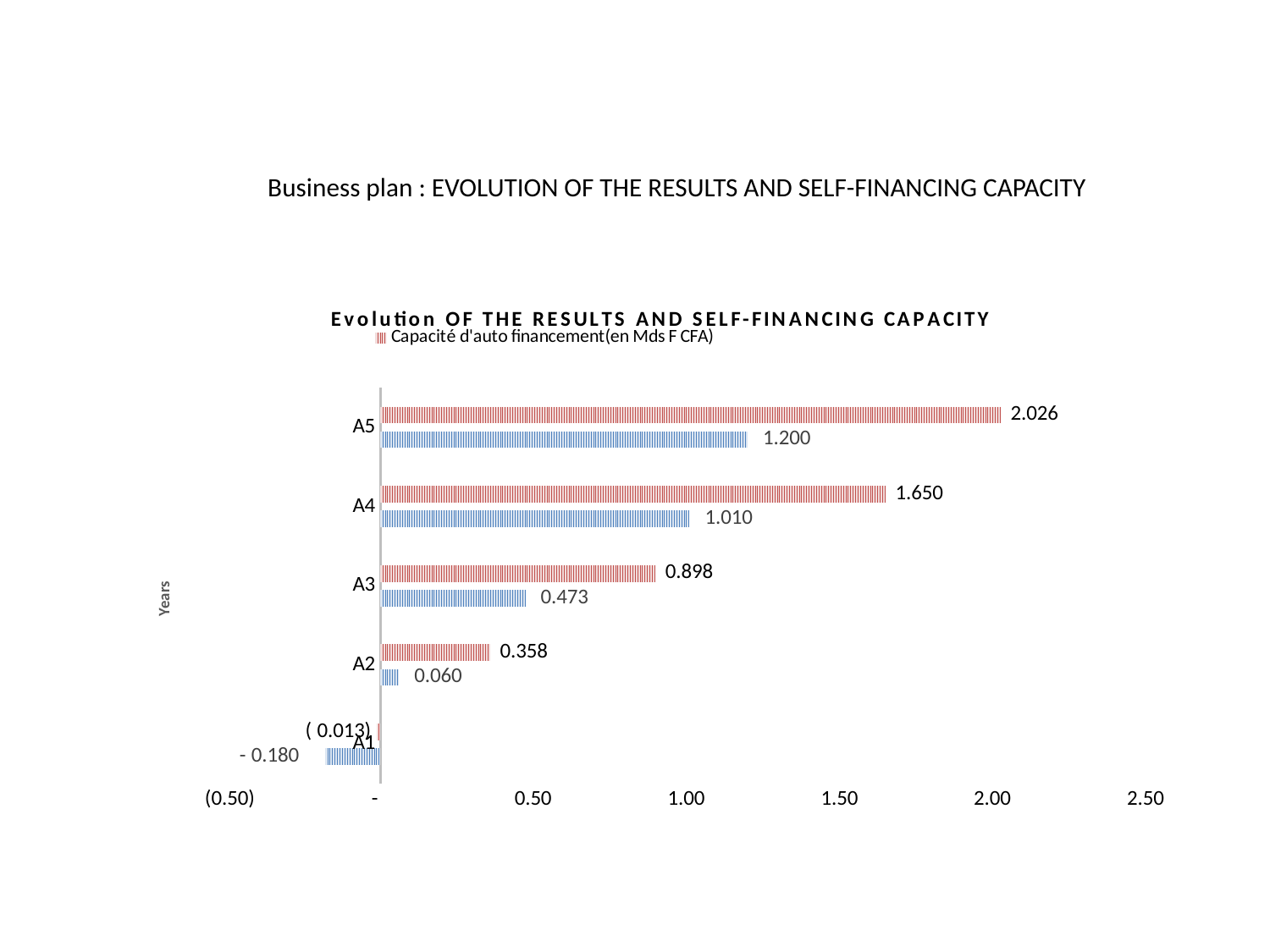
What is the difference between the Capacité d'auto financement for A5 and A4? 0.376 What is the value of the blue bar for A1? - 0.180 Which year has the lowest value for the blue series? A1 How many years are shown on the chart? 5 What is the label of the vertical axis? Years Which is larger for A3: the Capacité d'auto financement or the blue bar? Capacité d'auto financement Is the Capacité d'auto financement for A4 greater or less than 1.50? greater What kind of chart is shown on the slide? bar chart What is the value of Capacité d'auto financement for A2? 0.358 Which year has the highest Capacité d'auto financement? A5 What is the value of Capacité d'auto financement for A5? 2.026 What is the value of the blue bar for A4? 1.010